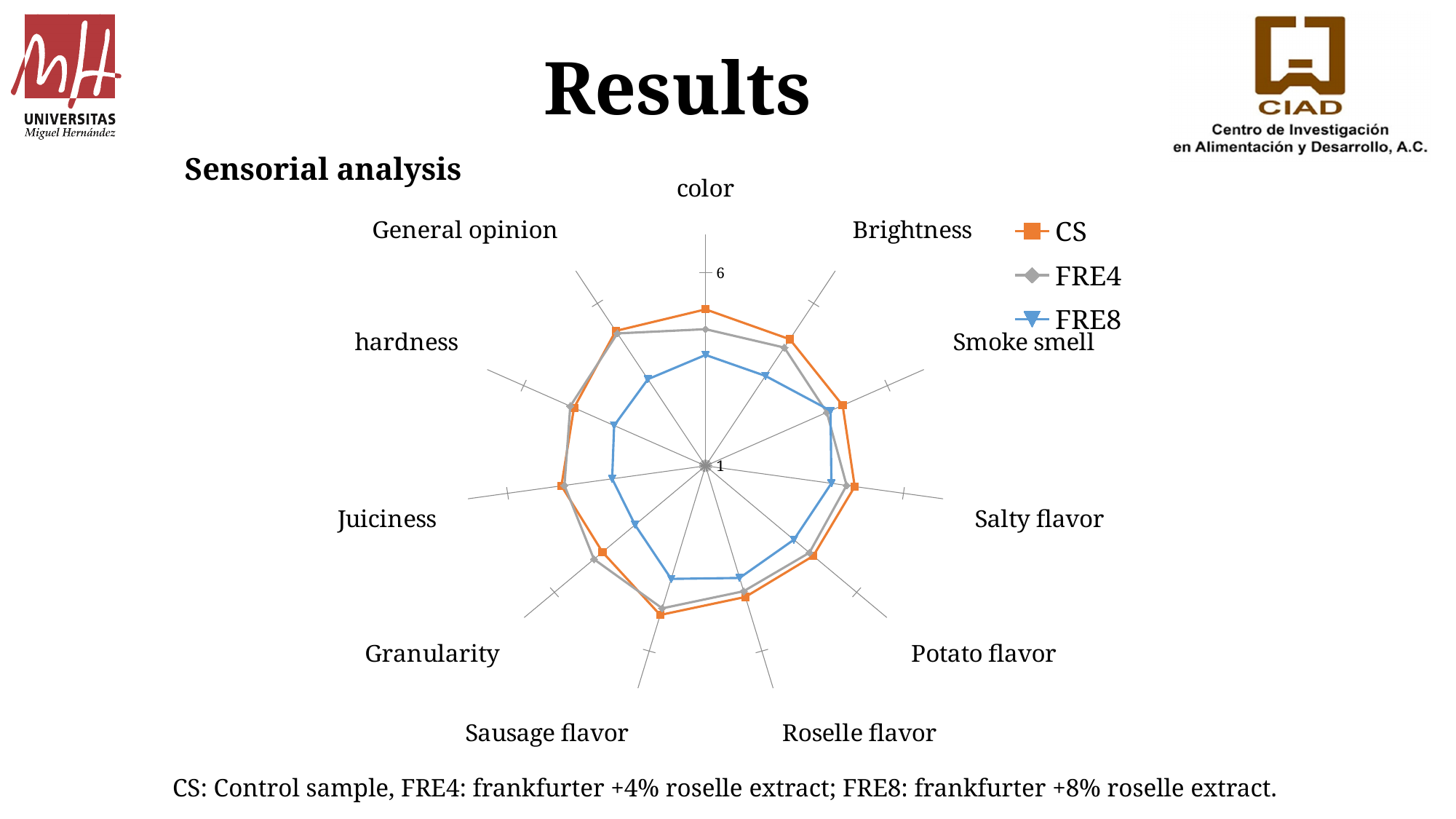
For Smoke smell, which series has the larger value, CS or FRE8? CS Is the FRE8 value for General opinion greater or less than 6? less How many series does the legend of the radar chart list? 3 What kind of chart is shown on the slide? Radar chart How many sensory attributes (axes) are plotted on the radar chart? 11 Is the CS value for Salty flavor greater or less than 6? less Which series is plotted with the blue triangle markers? FRE8 For Sausage flavor, which series has the larger value, CS or FRE8? CS For Juiciness, which series has the larger value, FRE4 or FRE8? FRE4 Which series has the lowest values across the attributes on the radar chart? FRE8 Which series is plotted with the orange square markers? CS